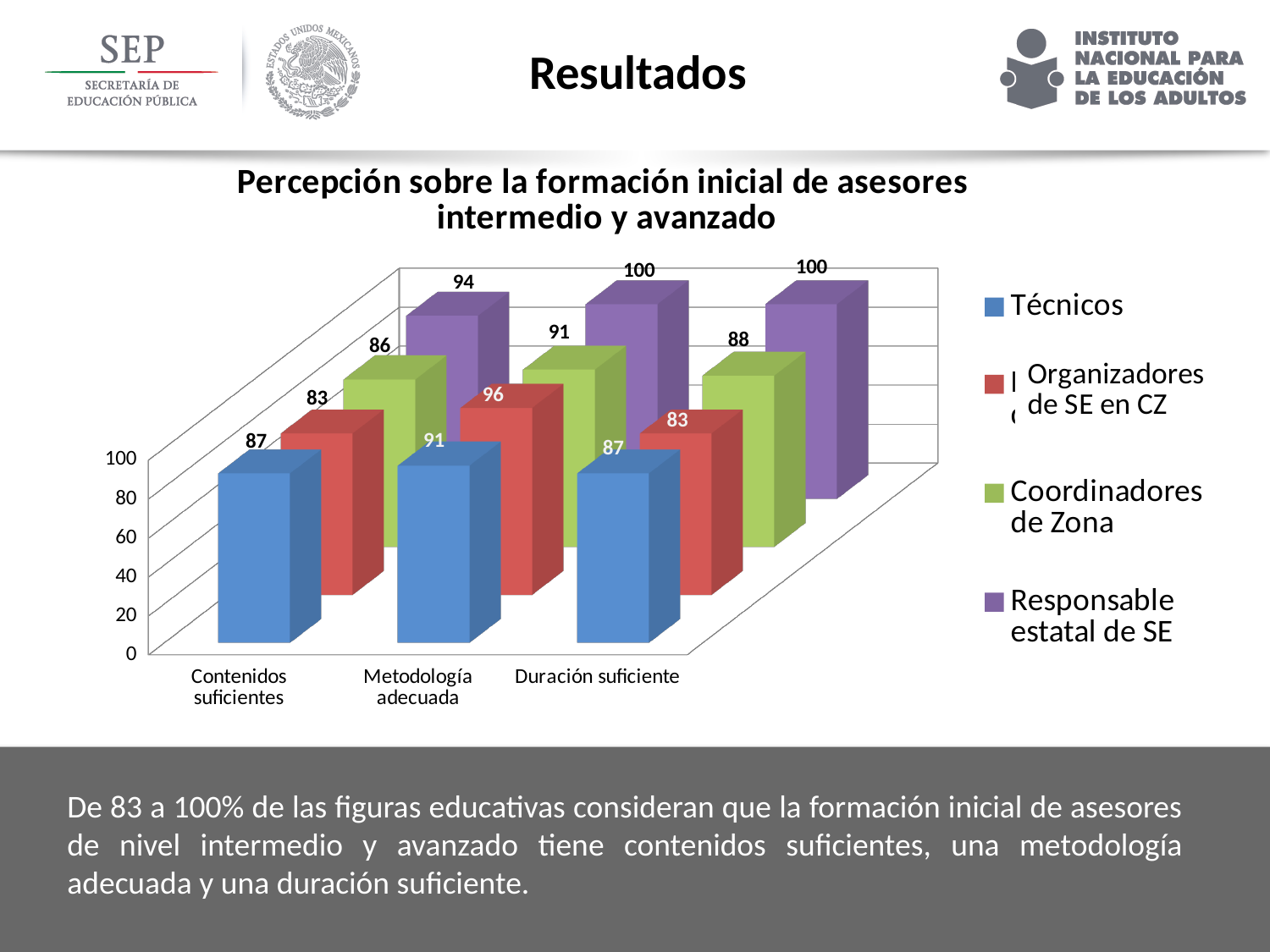
How many series does the legend list? 4 Which series has the lowest value in the Contenidos suficientes category? Organizadores de SE en CZ What is the value for Organizadores de SE en CZ in the Duración suficiente category? 83 What is the title of the chart? Percepción sobre la formación inicial de asesores intermedio y avanzado Which is larger: the Coordinadores de Zona value for Duración suficiente or for Contenidos suficientes? Duración suficiente What is the difference between the Organizadores de SE en CZ value for Metodología adecuada and for Duración suficiente? 13 What kind of chart is shown on the slide? Bar chart How many categories are shown on the x axis? 3 What is the value for Responsable estatal de SE in the Metodología adecuada category? 100 What is the value for Coordinadores de Zona in the Contenidos suficientes category? 86 What is the value for Técnicos in the Contenidos suficientes category? 87 Which series has the highest value in the Metodología adecuada category? Responsable estatal de SE